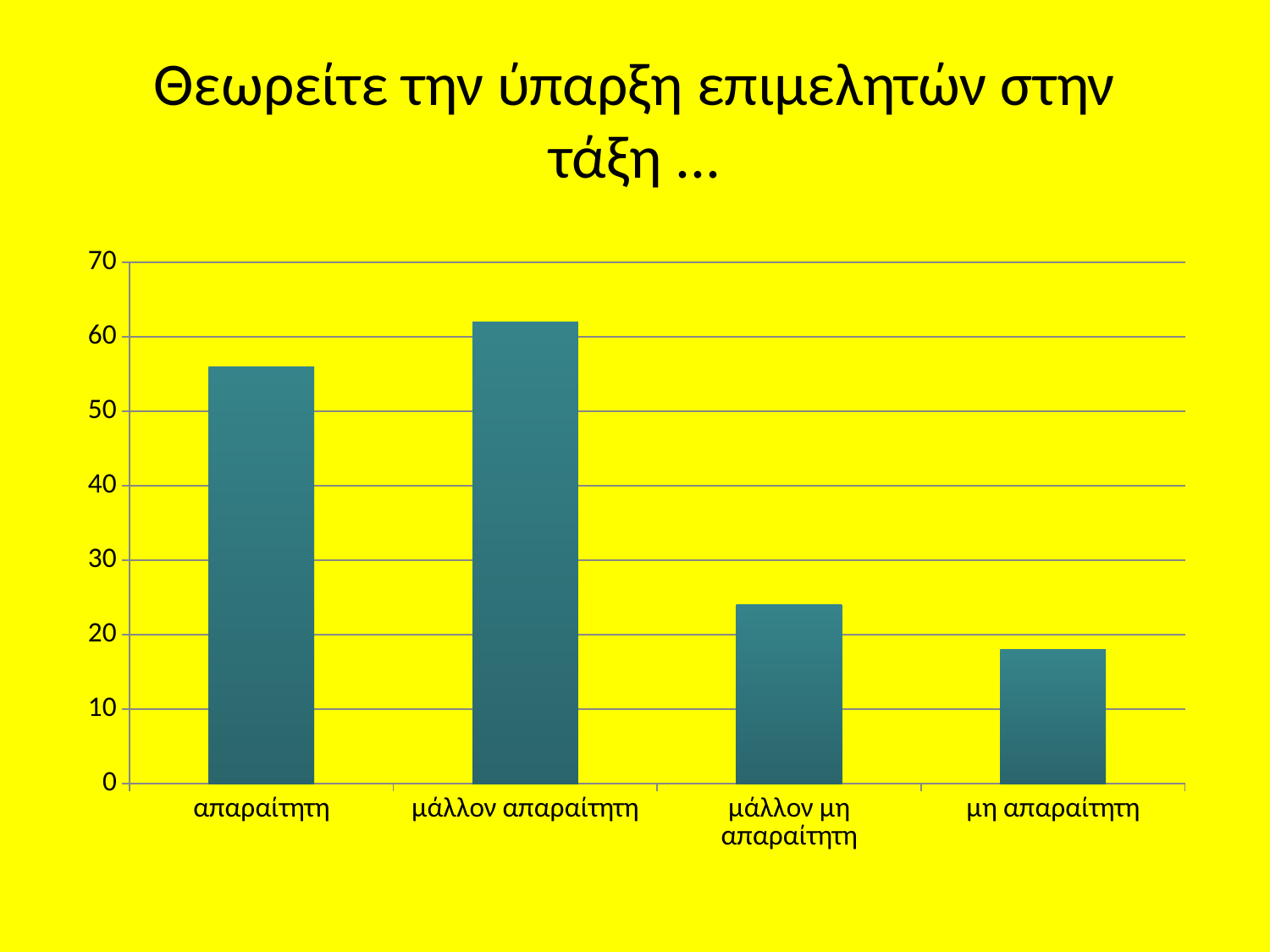
Which is larger, the value for μάλλον μη απαραίτητη or the value for μη απαραίτητη? μάλλον μη απαραίτητη Which category has the highest bar? μάλλον απαραίτητη Which is larger, the value for απαραίτητη or the value for μάλλον απαραίτητη? μάλλον απαραίτητη Is the value for απαραίτητη greater or less than 50? greater Is the value for μάλλον απαραίτητη greater or less than 60? greater What kind of chart is shown on the slide? bar chart What is the title of the chart? Θεωρείτε την ύπαρξη επιμελητών στην τάξη ... How many categories are shown on the x axis? 4 Is the value for μη απαραίτητη greater or less than 20? less What is the highest value shown on the y axis? 70 Which category has the lowest bar? μη απαραίτητη